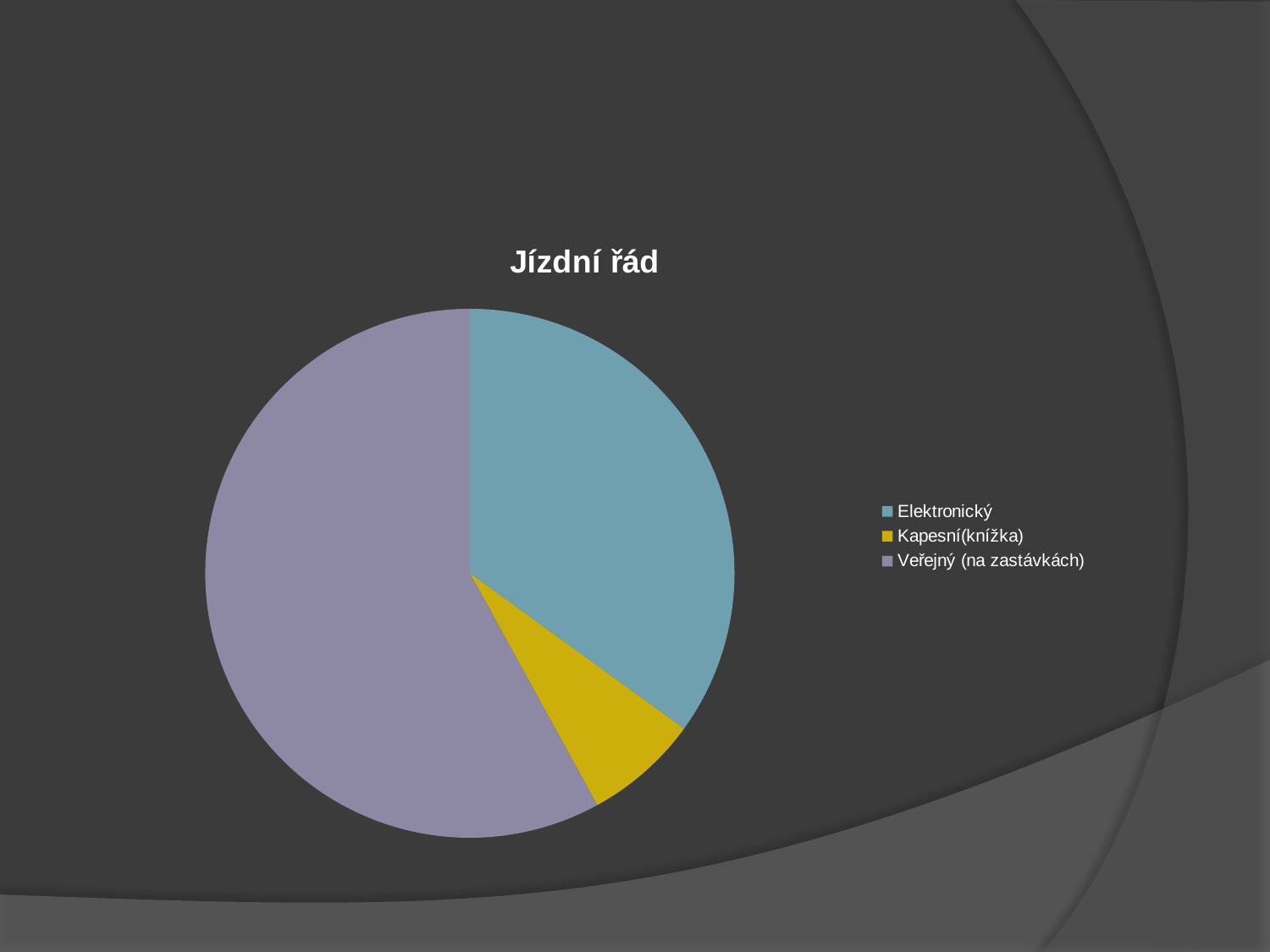
Which category has the largest slice of the pie? Veřejný (na zastávkách) What is the title of the chart? Jízdní řád How many slices does the pie chart have? 3 How many entries does the legend list? 3 Which slice is larger, Veřejný (na zastávkách) or Elektronický? Veřejný (na zastávkách) Which category is shown in yellow? Kapesní(knížka) What kind of chart is shown on the slide? pie chart Which category has the smallest slice of the pie? Kapesní(knížka) Is the Veřejný (na zastávkách) slice more or less than half of the pie? more Which slice is larger, Elektronický or Kapesní(knížka)? Elektronický